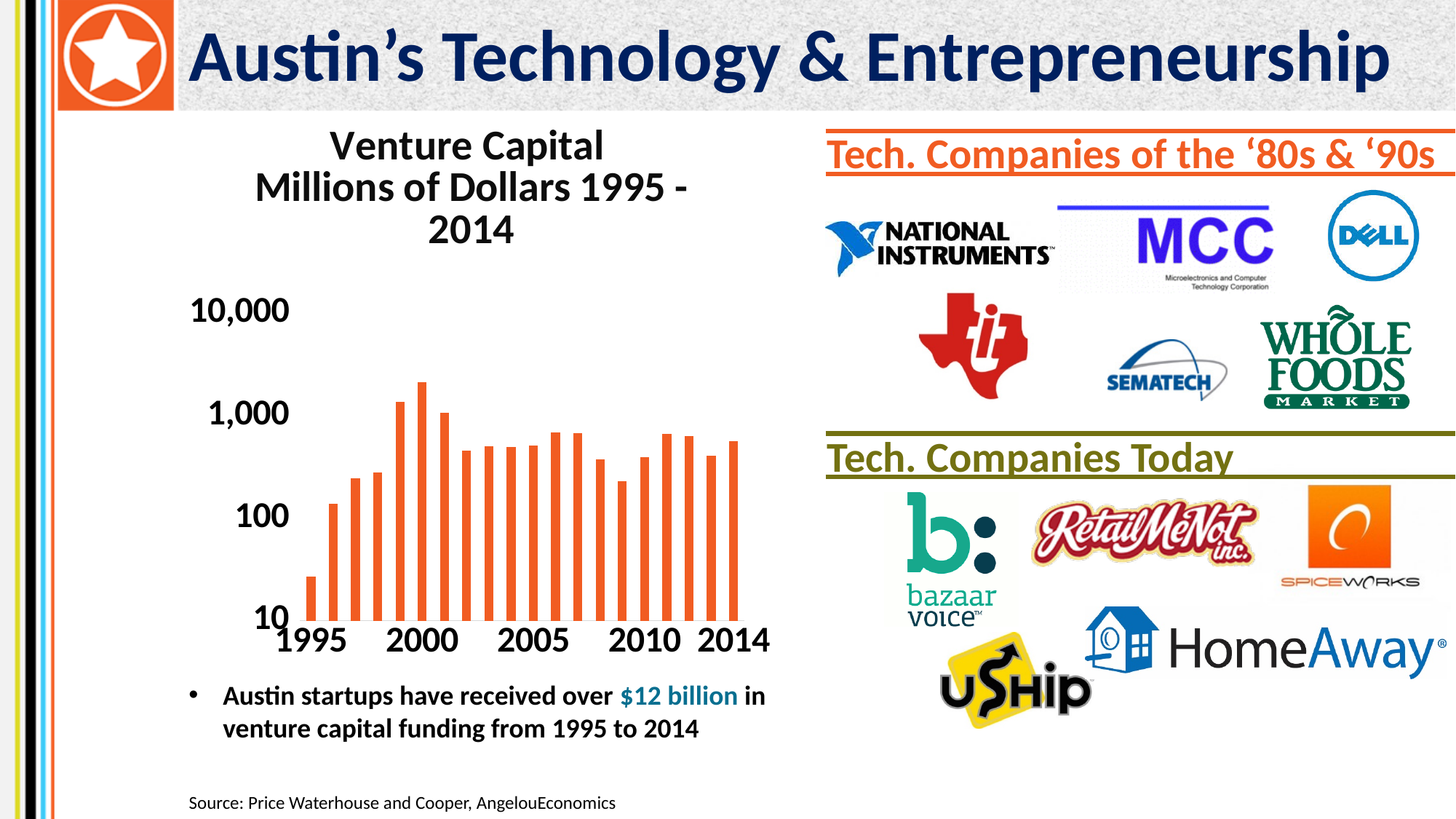
Which year has a larger venture capital bar, 2000 or 2010? 2000 Is the venture capital value for 2009 greater or less than 100? greater Is the venture capital value for 2000 greater or less than 1,000? greater Which year has the lowest venture capital bar in the chart? 1995 Which year has the highest venture capital bar in the chart? 2000 Do the venture capital values rise or fall from 1995 to 2000? rise Is the venture capital value for 1995 greater or less than 100? less Which year has a larger venture capital bar, 1995 or 1996? 1996 What is the title of the chart on the left of the slide? Venture Capital Millions of Dollars 1995 - 2014 How many bars (years) are plotted in the venture capital chart? 20 What kind of chart is shown under the title "Venture Capital Millions of Dollars 1995 - 2014"? bar chart